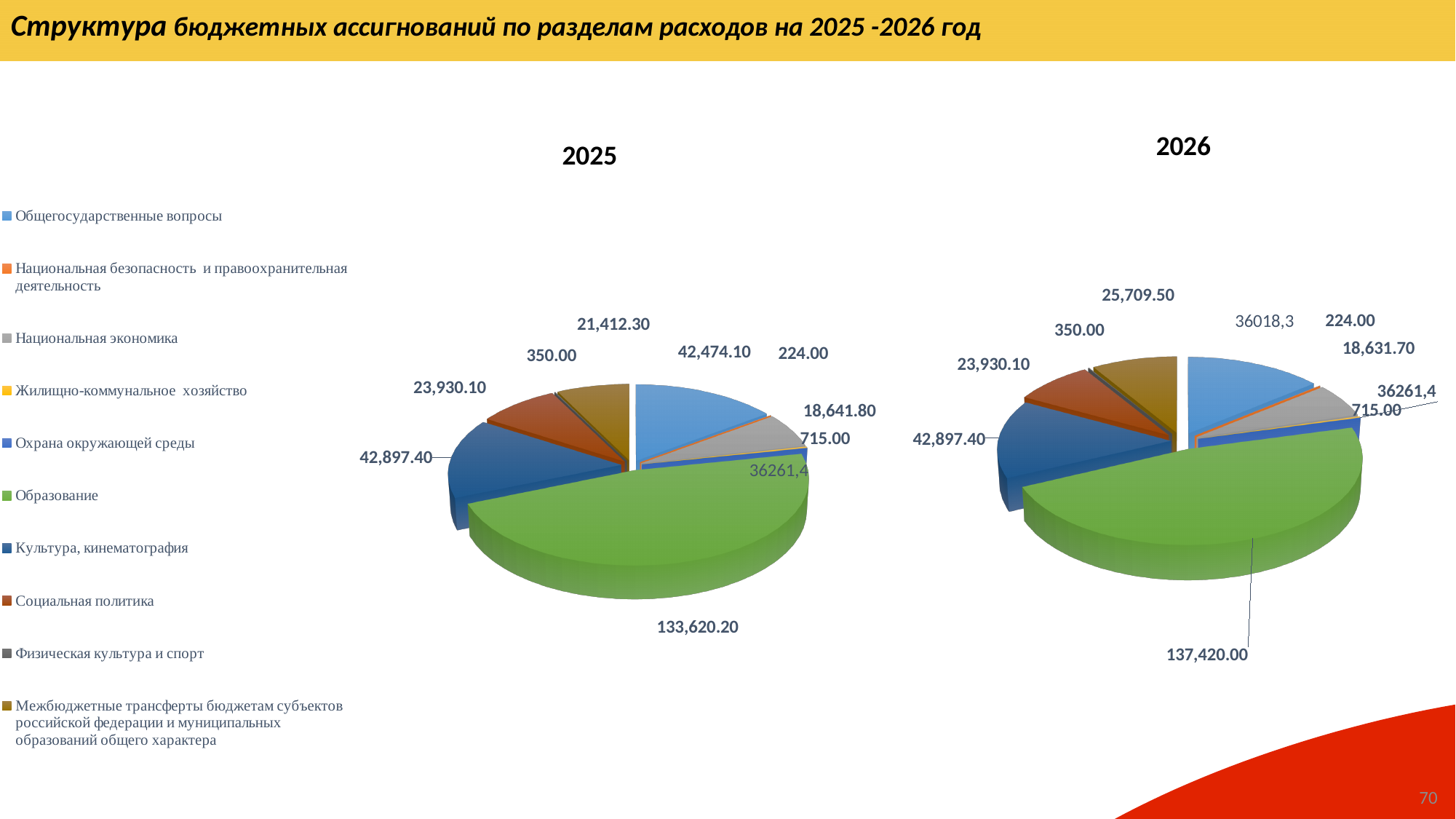
In the 2026 chart, what is the value for Образование? 137,420.00 In the 2025 chart, which category has the largest slice? Образование In the 2025 chart, what is the value for Образование? 133,620.20 In the 2025 chart, what is the value for Культура, кинематография? 42,897.40 In the 2025 chart, which is larger: Образование or Культура, кинематография? Образование In the 2026 chart, what is the value for Социальная политика? 23,930.10 What kind of chart is the 2025 chart? pie chart What colour is the Образование slice in both charts? green In the 2026 chart, which category has the largest slice? Образование How many categories does the legend list? 10 In the 2026 chart, what is the value for Межбюджетные трансферты бюджетам субъектов российской федерации и муниципальных образований общего характера? 25,709.50 What is the difference between the Образование value in the 2026 chart and in the 2025 chart? 3,799.80